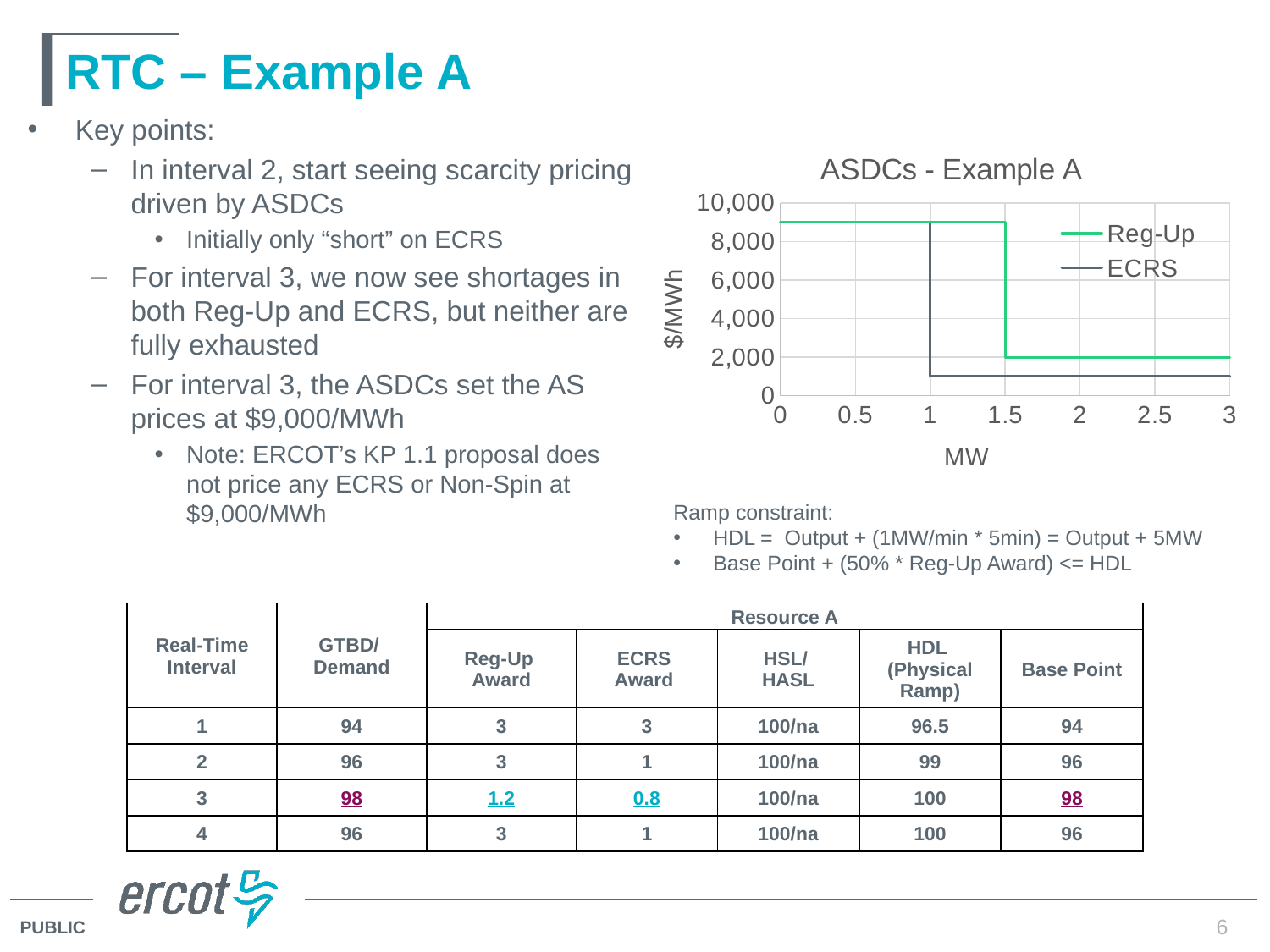
What is the title of the chart on the slide? ASDCs - Example A At 1.25 MW, which series has the higher value, Reg-Up or ECRS? Reg-Up What kind of chart is shown on the slide? line chart What are the two series named in the legend of the chart? Reg-Up and ECRS Is the ECRS value at 2 MW greater or less than 2,000? less Is the Reg-Up value at 0.5 MW greater or less than 8,000? greater At 2 MW, which series has the higher value, Reg-Up or ECRS? Reg-Up At what MW value does the Reg-Up line step down from its high level? 1.5 Do the Reg-Up and ECRS values rise or fall as MW increases along the x axis? fall Is the Reg-Up value at 2.5 MW greater or less than 4,000? less At what MW value does the ECRS line step down from its high level? 1 How many series does the legend of the ASDCs - Example A chart list? 2